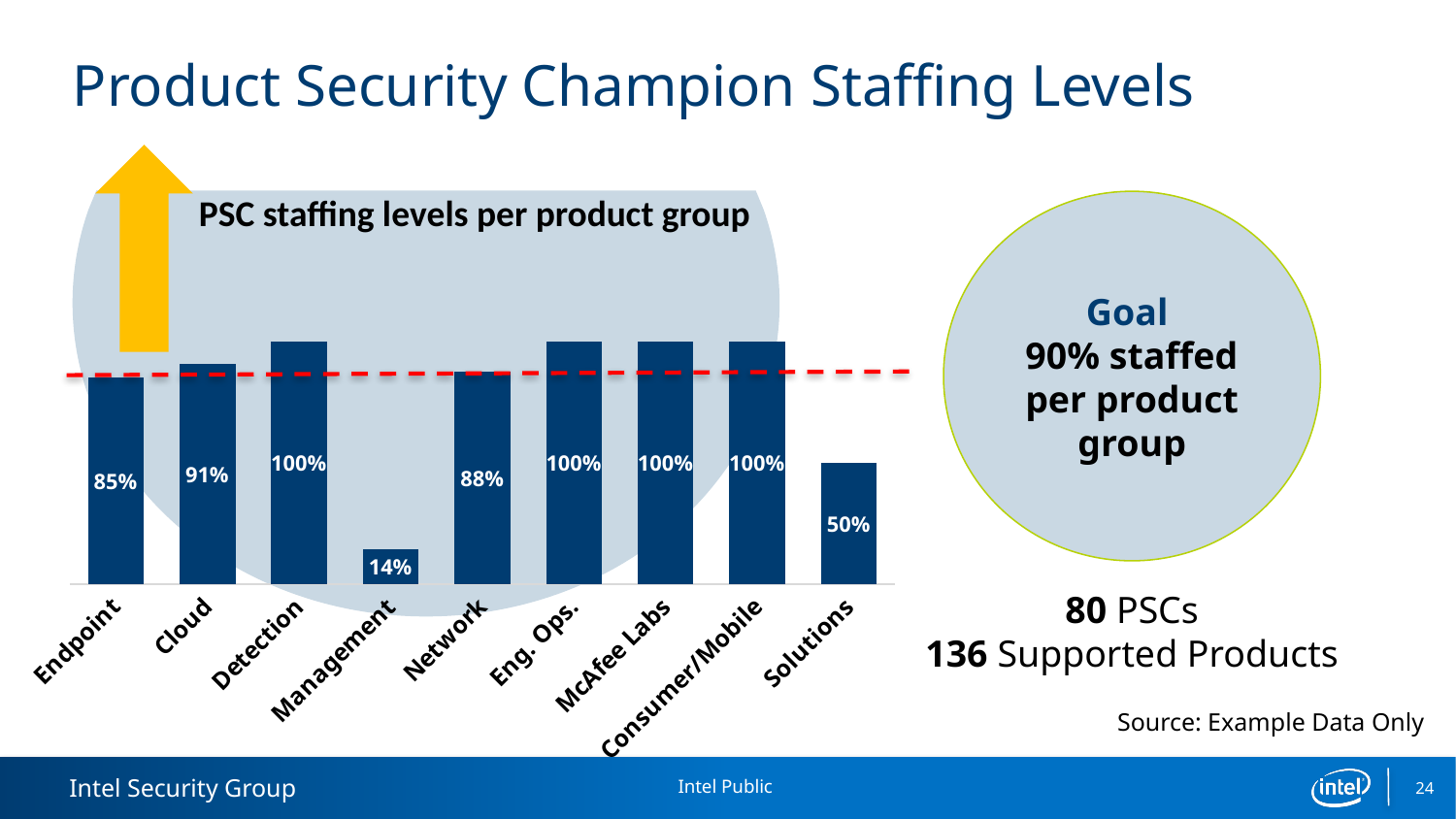
Which has a higher PSC staffing level, Solutions or Management? Solutions What is the title of the chart? PSC staffing levels per product group What type of chart is used to show PSC staffing levels per product group? Bar chart What is the PSC staffing level for Management? 14% Which product group has the lowest PSC staffing level? Management What is the PSC staffing level for Network? 88% Which has a higher PSC staffing level, Cloud or Network? Cloud What is the PSC staffing level for Solutions? 50% What is the PSC staffing level for Endpoint? 85% What is the difference between the staffing levels of Cloud and Endpoint? 6% What is the difference between the staffing levels of Detection and Solutions? 50% How many product groups are shown in the chart? 9